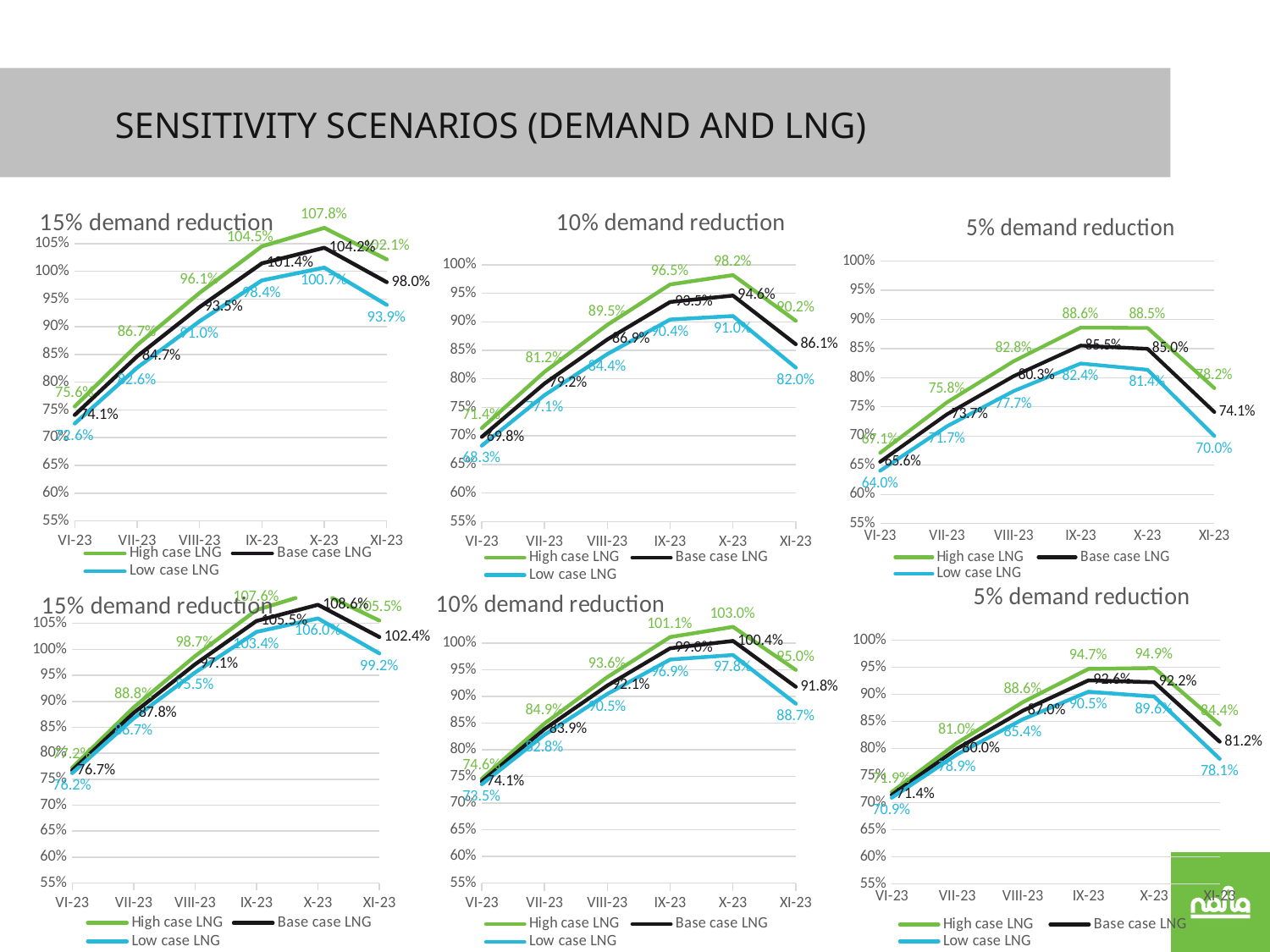
How many series does the legend list in the bottom-left chart titled '15% demand reduction'? 3 In the top-right chart titled '5% demand reduction', what is the Base case LNG value at XI-23? 74.1% In the bottom-middle chart titled '10% demand reduction', what is the High case LNG value at X-23? 103.0% In the top-left chart titled '15% demand reduction', what is the High case LNG value at X-23? 107.8% In the bottom-right chart titled '5% demand reduction', which month has the lowest Low case LNG value? VI-23 In the top-right chart titled '5% demand reduction', what is the difference between the High case LNG and Low case LNG values at XI-23? 8.2% In the top-middle chart titled '10% demand reduction', what is the Low case LNG value at XI-23? 82.0% In the bottom-right chart titled '5% demand reduction', what is the Low case LNG value at XI-23? 78.1% In the top-middle chart titled '10% demand reduction', which month has the highest High case LNG value? X-23 In the top-left chart titled '15% demand reduction', what is the Base case LNG value at XI-23? 98.0% How many months are shown on the x axis of the top-left chart titled '15% demand reduction'? 6 In the bottom-middle chart titled '10% demand reduction', which is larger at XI-23: the Base case LNG value or the Low case LNG value? Base case LNG